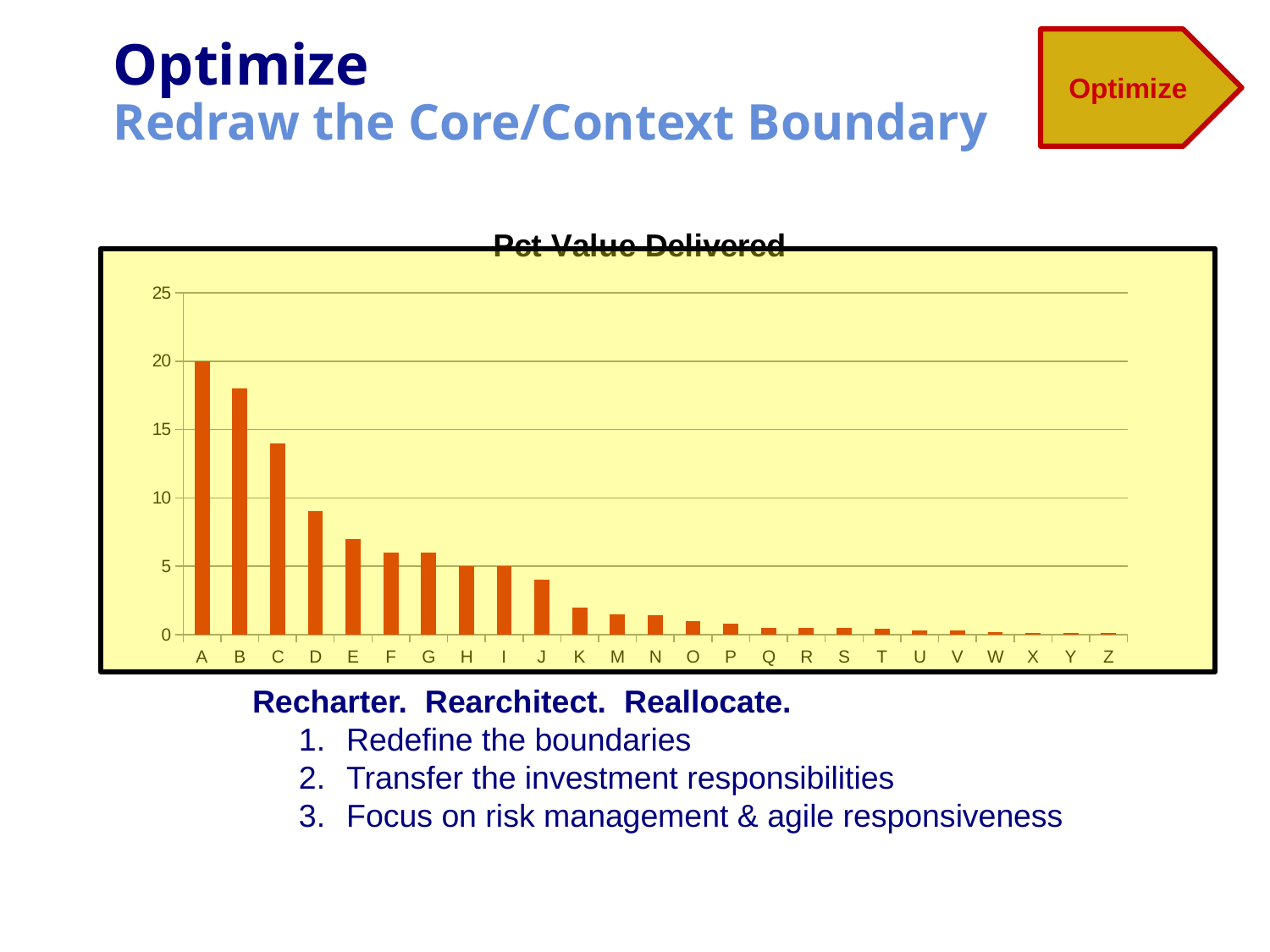
Which is larger, the value for C or the value for D? C Is the value for C greater or less than 15? less Do the values rise or fall moving from left to right along the x axis? fall How many categories are shown on the x axis of the chart? 25 What kind of chart is shown on the slide? bar chart What is the title of the chart? Pct Value Delivered What is the value for category A in the Pct Value Delivered chart? 20 Which category has the highest value in the Pct Value Delivered chart? A Is the value for B greater or less than 15? greater Is the value for K greater or less than 5? less